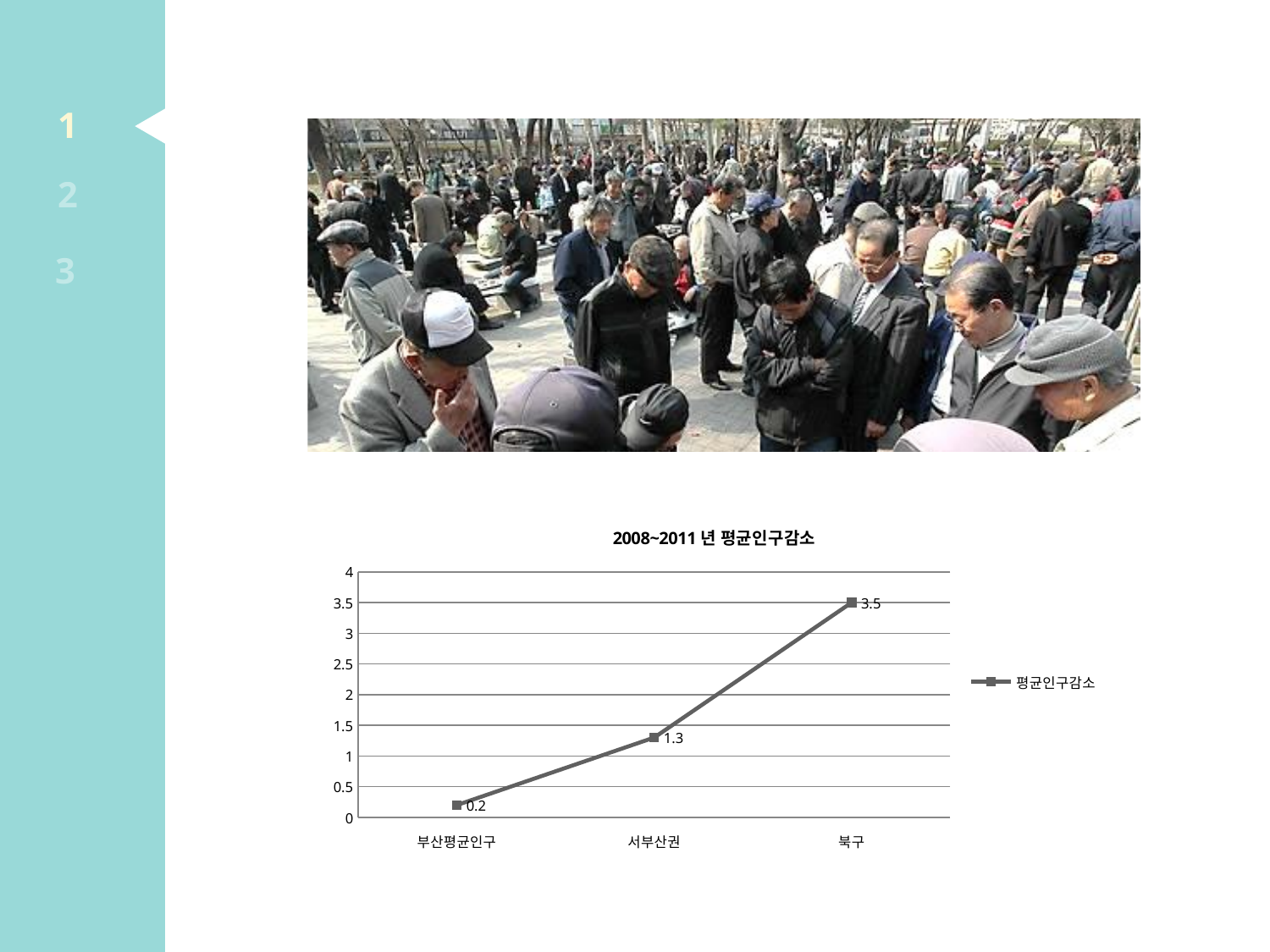
How many categories are shown on the x axis? 3 What is the title of the chart? 2008~2011 년 평균인구감소 Which category has the highest value? 북구 What is the value for 북구? 3.5 How many series does the legend list? 1 What is the difference between the values for 서부산권 and 부산평균인구? 1.1 What is the difference between the values for 북구 and 서부산권? 2.2 Which is larger, the value for 서부산권 or the value for 부산평균인구? 서부산권 What is the value for 서부산권? 1.3 What kind of chart is shown on the slide? line chart Which category has the lowest value? 부산평균인구 What is the value for 부산평균인구? 0.2